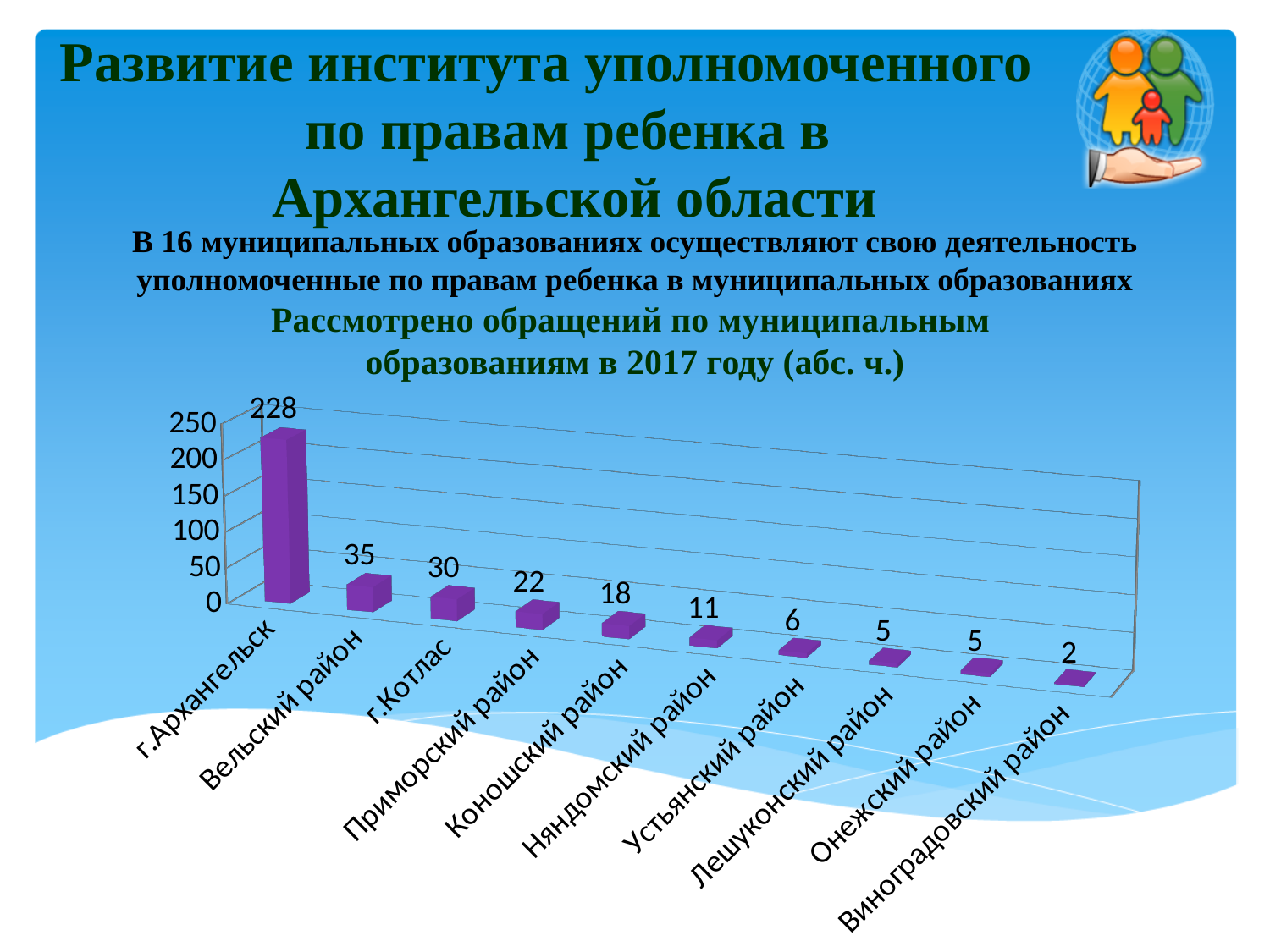
What is the value for Виноградовский район? 2 What is the value for Коношский район? 18 What is the difference between the values for г.Архангельск and Вельский район? 193 Which is larger, the value for Няндомский район or the value for Устьянский район? Няндомский район What is the value for г.Архангельск? 228 What kind of chart is shown on the slide? bar chart What is the difference between the values for г.Котлас and Приморский район? 8 Which category has the highest value? г.Архангельск Which category has the lowest value? Виноградовский район How many categories are shown on the chart? 10 Do the values rise or fall from left to right along the x axis? fall What is the value for Вельский район? 35